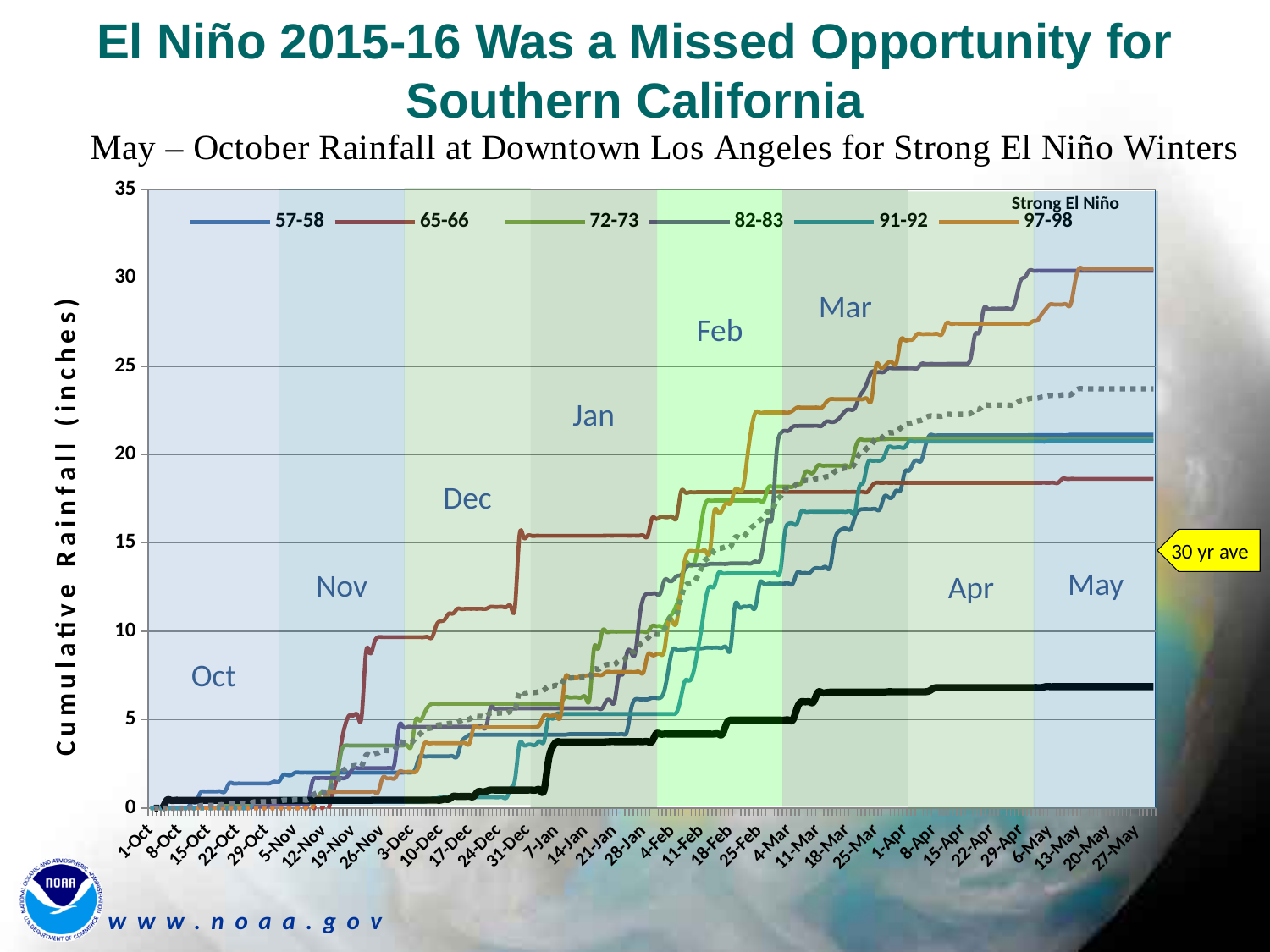
What is the title shown above the legend entries? Strong El Niño Which series is highest at the end of December? 65-66 What is the label of the vertical axis? Cumulative Rainfall (inches) At the end of May, is the value for 97-98 greater or less than 25? greater How many months are labeled across the chart area? 8 At the end of May, is the 30 yr ave line greater or less than 25? less Do the series values rise or fall along the x axis from October to May? rise Among the series listed in the legend, which ends lowest at the end of May? 65-66 How many El Niño winter series does the chart legend list? 6 At the end of May, which is larger: 82-83 or 65-66? 82-83 What kind of chart is shown on the slide? Line chart At the end of May, is the value for 65-66 greater or less than 20? less